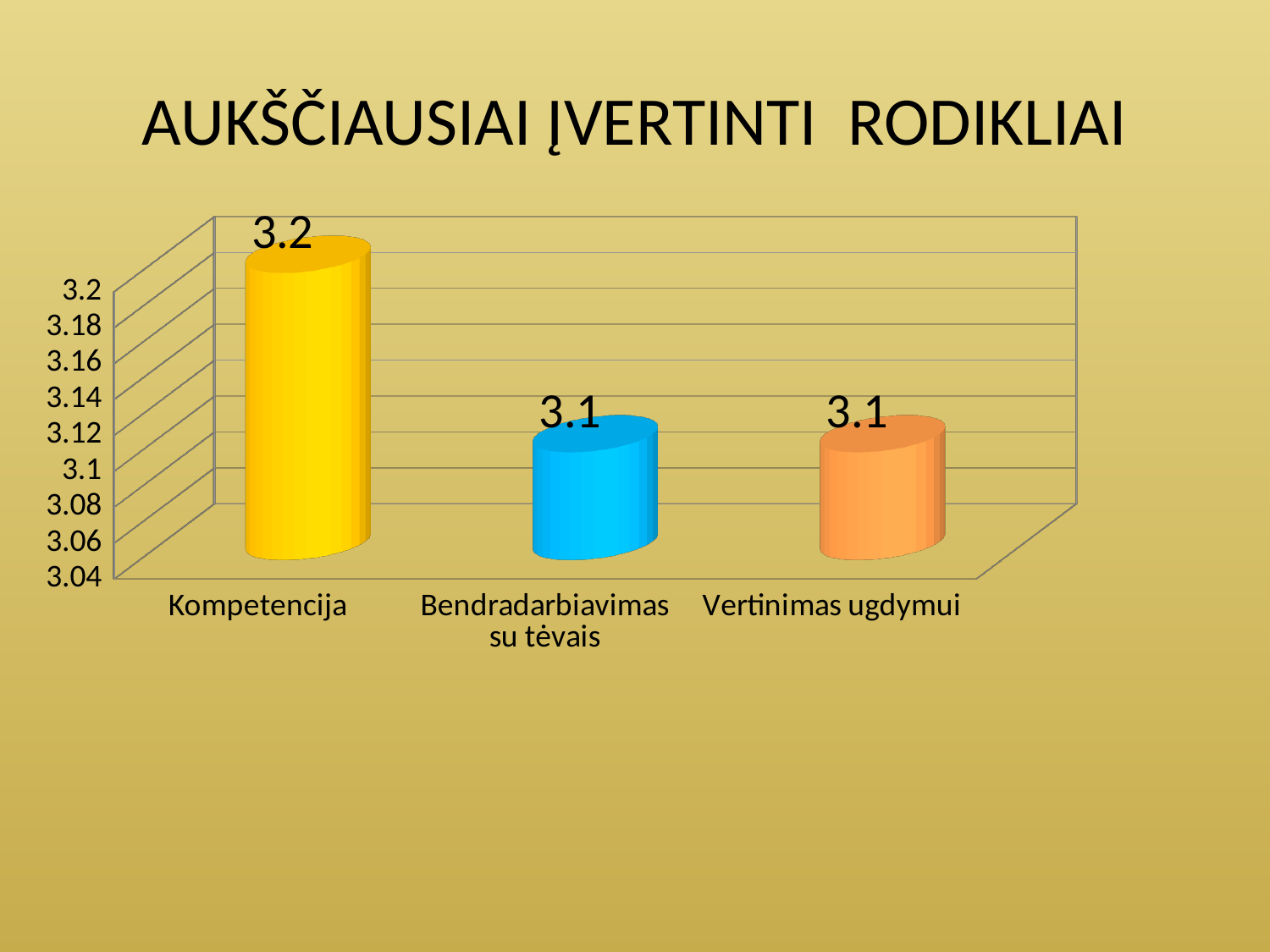
Which category has the highest value? Kompetencija What colour is the bar for Kompetencija? yellow Is the value for Bendradarbiavimas su tėvais greater or less than 3.16? less What kind of chart is shown on the slide? bar chart What is the difference between the values for Kompetencija and Bendradarbiavimas su tėvais? 0.1 Which is larger, the value for Kompetencija or the value for Vertinimas ugdymui? Kompetencija How many categories are shown in the chart? 3 What is the value for Bendradarbiavimas su tėvais? 3.1 What is the value for Vertinimas ugdymui? 3.1 What is the value for Kompetencija? 3.2 What is the title of the slide? AUKŠČIAUSIAI ĮVERTINTI RODIKLIAI